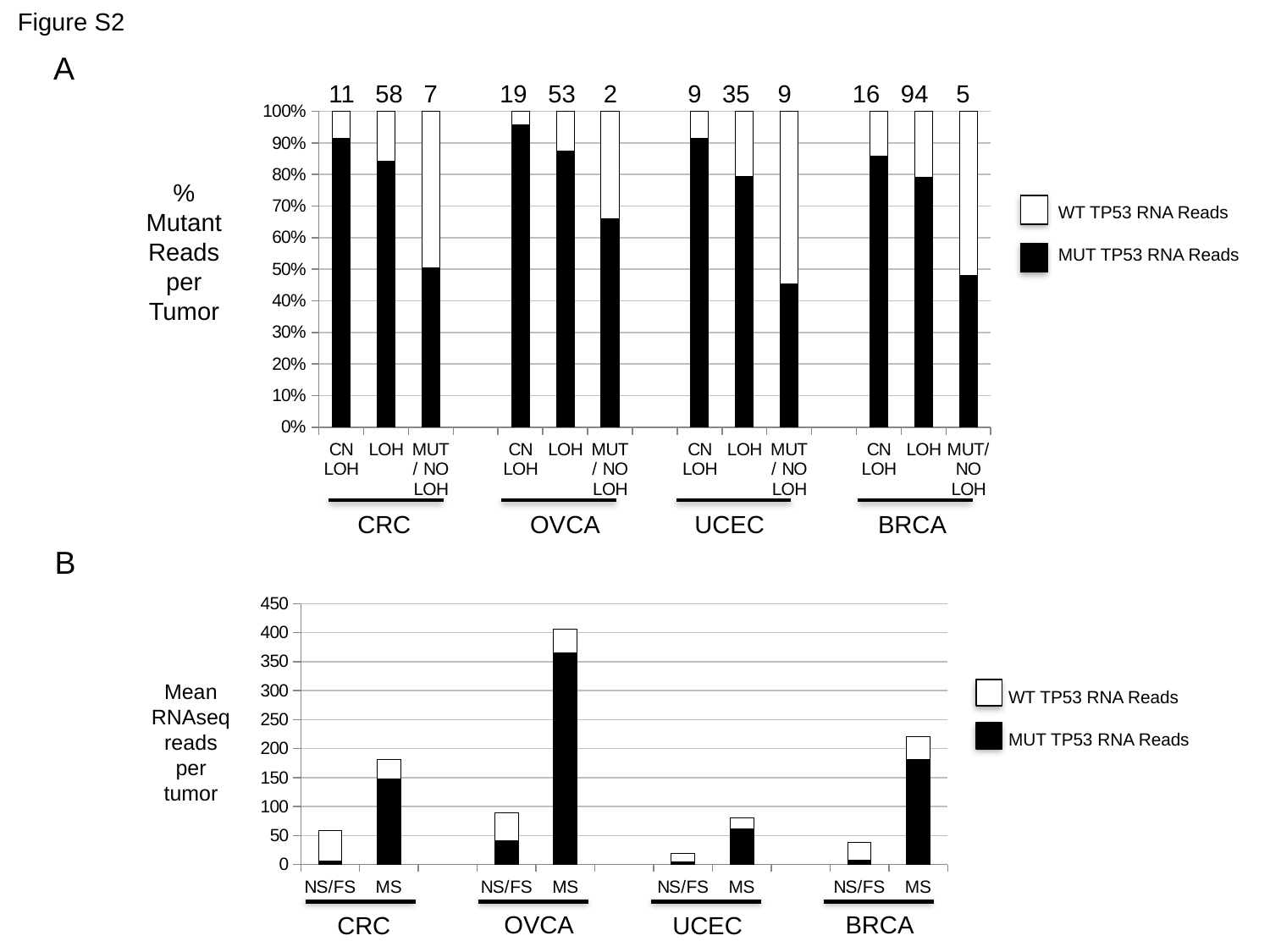
How many bars are plotted in chart A (% Mutant Reads per Tumor)? 12 In chart A (% Mutant Reads per Tumor), is the MUT TP53 RNA Reads share for UCEC MUT/NO LOH greater or less than 50%? less What kind of chart is chart A (% Mutant Reads per Tumor)? bar chart In chart B (Mean RNAseq reads per tumor), is the total for UCEC NS/FS greater or less than 50? less In chart B (Mean RNAseq reads per tumor), is the total for OVCA MS greater or less than 350? greater How many bars are plotted in chart B (Mean RNAseq reads per tumor)? 8 In chart A (% Mutant Reads per Tumor), what number is printed above the BRCA LOH bar? 94 In chart B (Mean RNAseq reads per tumor), which is taller: the CRC MS bar or the BRCA MS bar? BRCA MS How many series does the legend of chart B (Mean RNAseq reads per tumor) list? 2 In chart B (Mean RNAseq reads per tumor), which bar is the shortest? UCEC NS/FS In chart B (Mean RNAseq reads per tumor), which bar is the tallest? OVCA MS